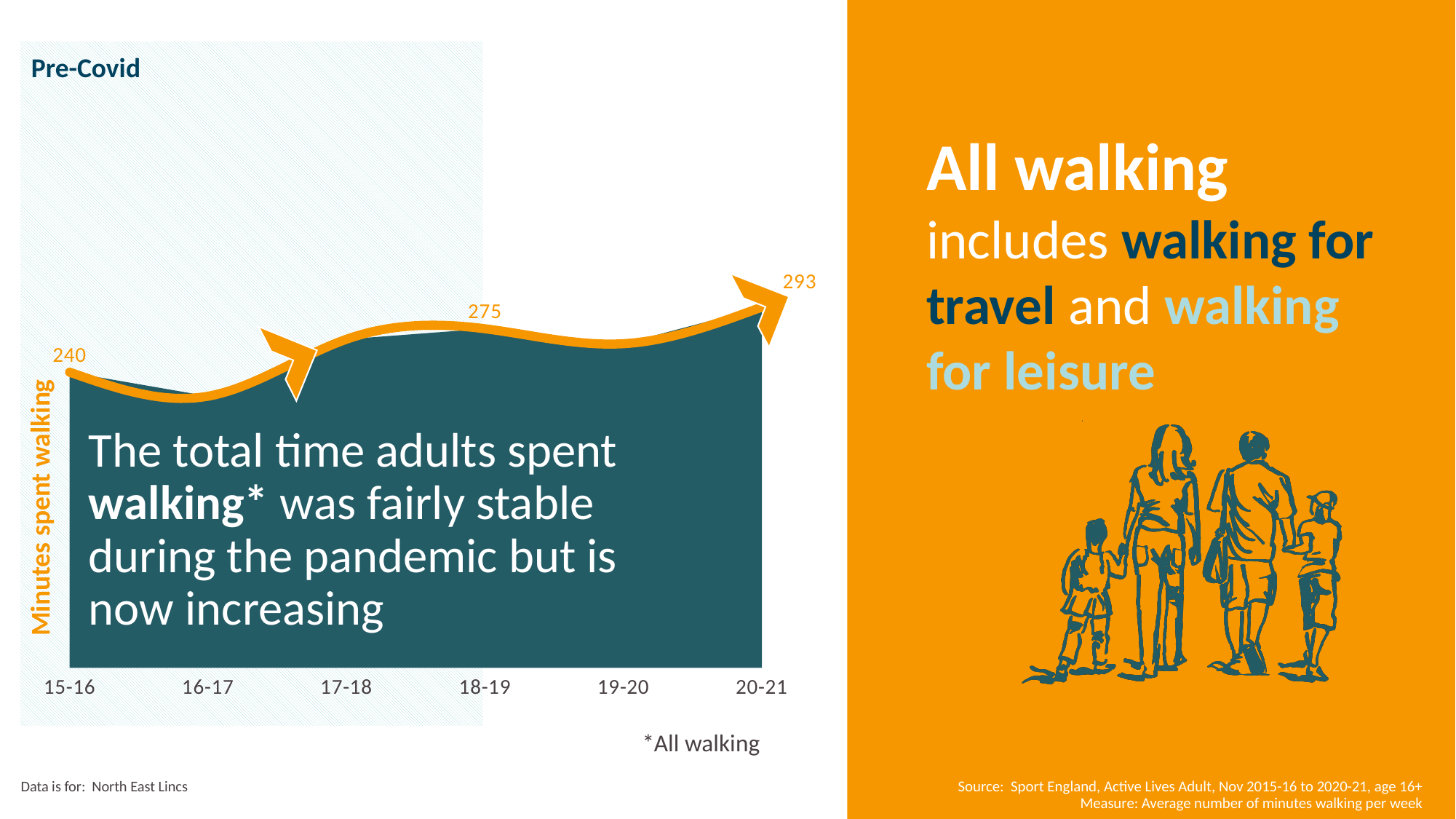
What is the label on the vertical axis? Minutes spent walking What is the difference between the values for 20-21 and 18-19? 18 Do the values rise or fall overall from 15-16 to 20-21? rise What is the value for 20-21? 293 Which is larger, the value for 20-21 or the value for 15-16? 20-21 What label is given to the shaded period covering 15-16 to 18-19? Pre-Covid What kind of chart is this? area chart Which year has the highest minutes spent walking? 20-21 What is the value for 18-19? 275 What is the value for 15-16? 240 What is the difference between the values for 20-21 and 15-16? 53 How many years are shown on the x axis? 6